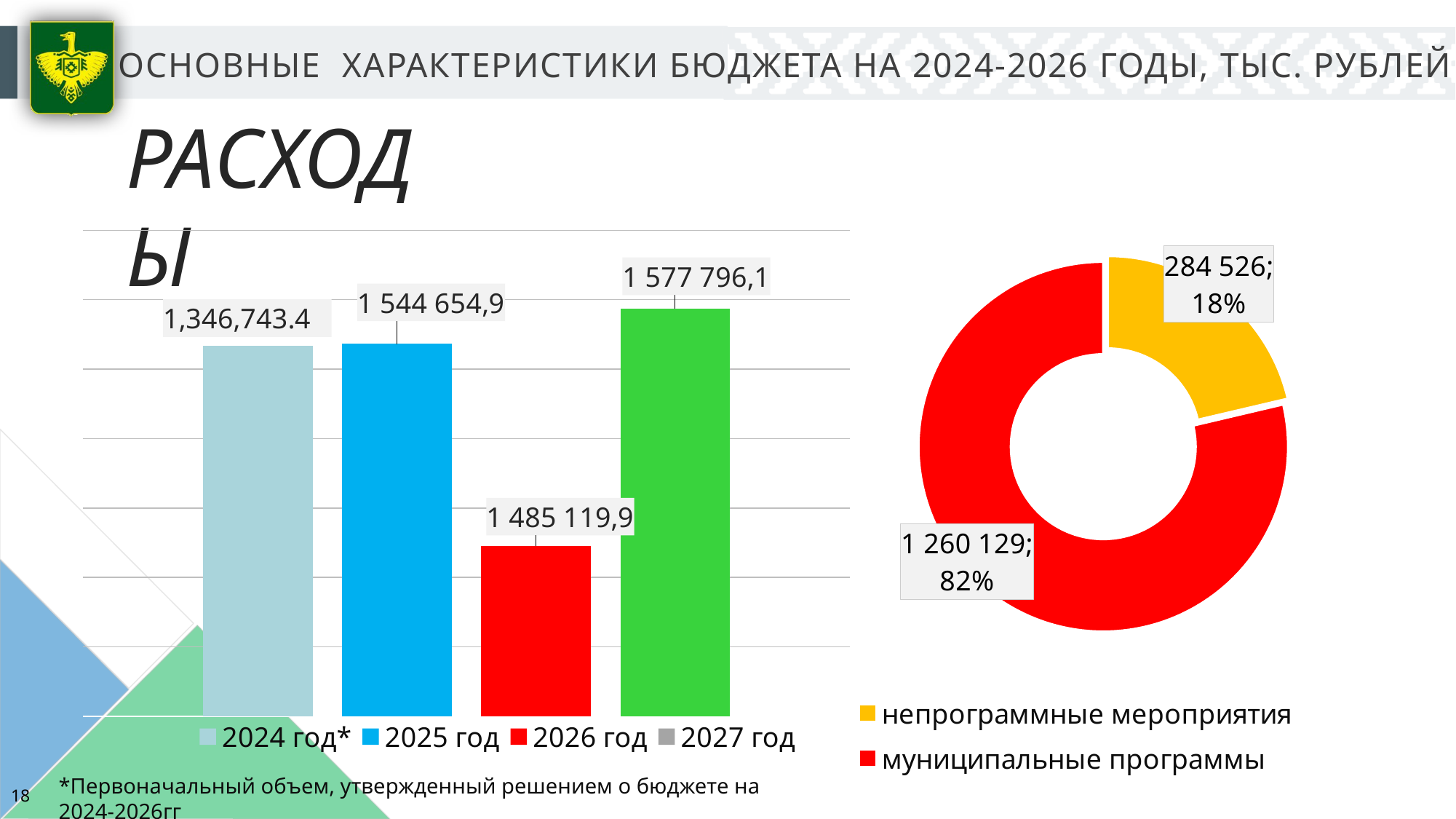
In the bar chart on the left, which year has the lowest value? 2024 год* In the doughnut chart on the right, what is the value for муниципальные программы? 1 260 129 In the doughnut chart on the right, what is the total of the two slices? 1 544 655 In the bar chart on the left, how many series does the legend list? 4 In the bar chart on the left, what is the difference between the values for 2025 год and 2026 год? 59 535,0 In the doughnut chart on the right, what share does непрограммные мероприятия have? 18% In the bar chart on the left, which is larger: the value for 2025 год or the value for 2026 год? 2025 год In the bar chart on the left, what is the value for 2024 год*? 1,346,743.4 In the bar chart on the left, what is the value for 2025 год? 1 544 654,9 In the bar chart on the left, what is the value for 2026 год? 1 485 119,9 In the bar chart on the left, which year has the highest value? 2027 год What kind of chart is the chart on the left of the slide? Bar chart